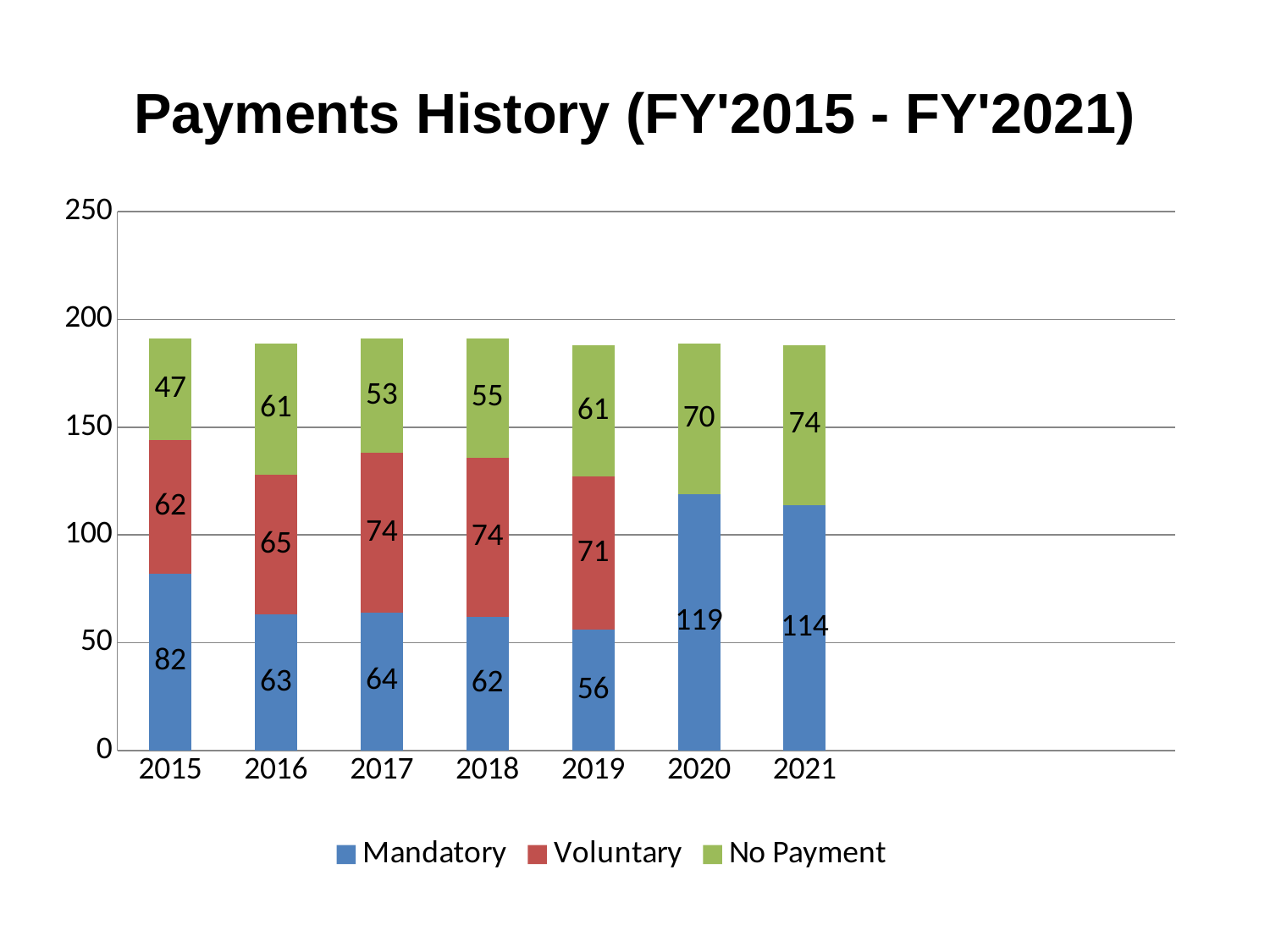
What is the Voluntary value for 2017? 74 Which is larger, the Voluntary value for 2016 or for 2019? 2019 What kind of chart is shown on the slide? Stacked bar chart What is the total of the stacked bar for 2015? 191 How many series does the legend list? 3 How many years are shown on the x axis? 7 Which year has the highest Mandatory value? 2020 Which year has the lowest No Payment value? 2015 What is the Mandatory value for 2015? 82 Is the total of the stacked bar for 2018 greater or less than 200? less What is the No Payment value for 2021? 74 What is the difference between the Mandatory values for 2020 and 2021? 5